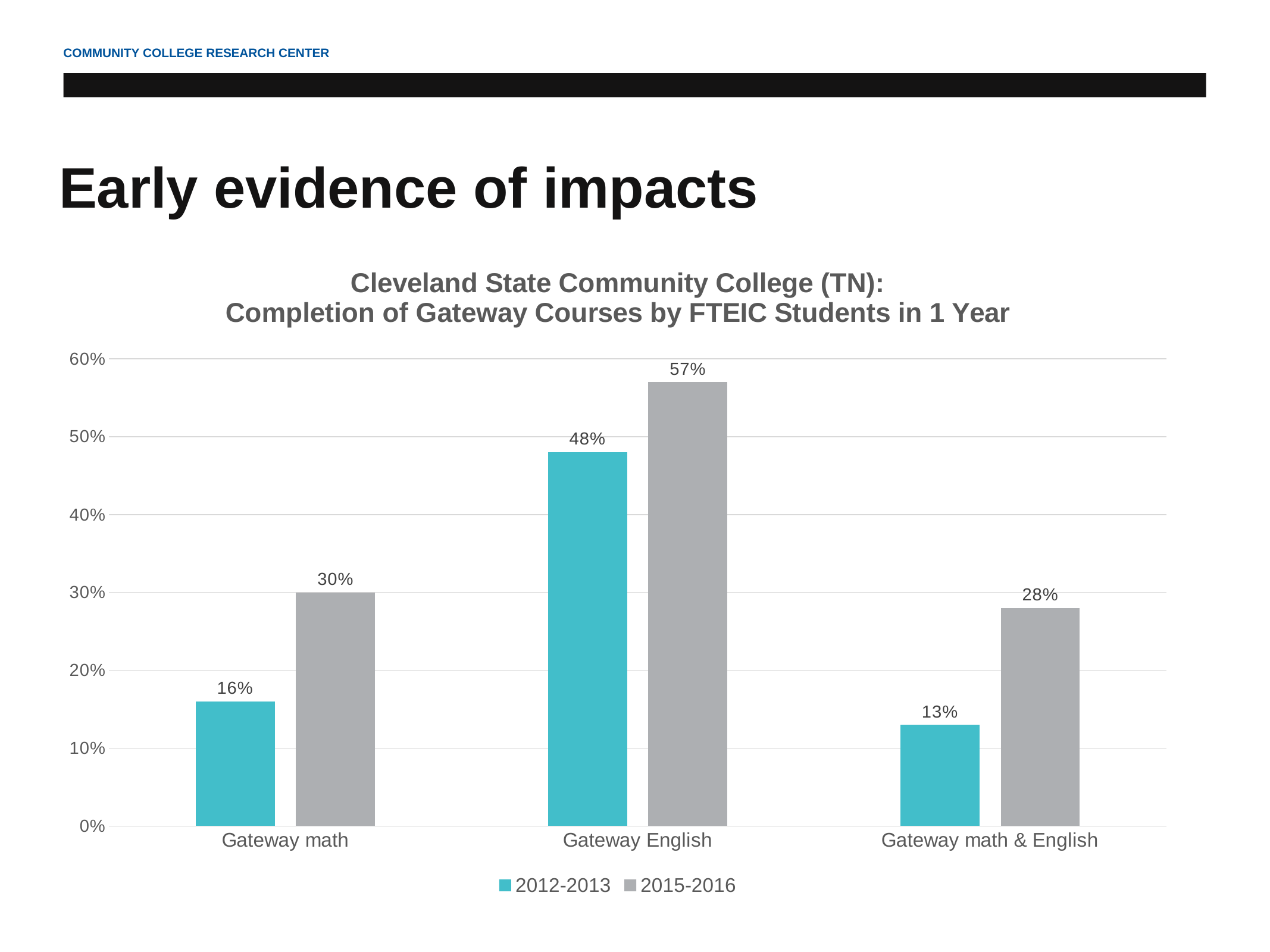
What is the value for Gateway math in the 2012-2013 series? 16% Which is larger for Gateway math & English: the 2012-2013 value or the 2015-2016 value? 2015-2016 What kind of chart is shown on the slide? bar chart How many series does the legend list? 2 How many categories are shown on the x axis? 3 What is the value for Gateway math & English in the 2012-2013 series? 13% Which category has the lowest value in the 2012-2013 series? Gateway math & English What is the difference between the 2015-2016 and 2012-2013 values for Gateway math? 14% Which category has the highest value in the 2015-2016 series? Gateway English Is the 2015-2016 value for Gateway math greater or less than 20%? greater What is the value for Gateway English in the 2015-2016 series? 57% What is the difference between the 2015-2016 and 2012-2013 values for Gateway English? 9%